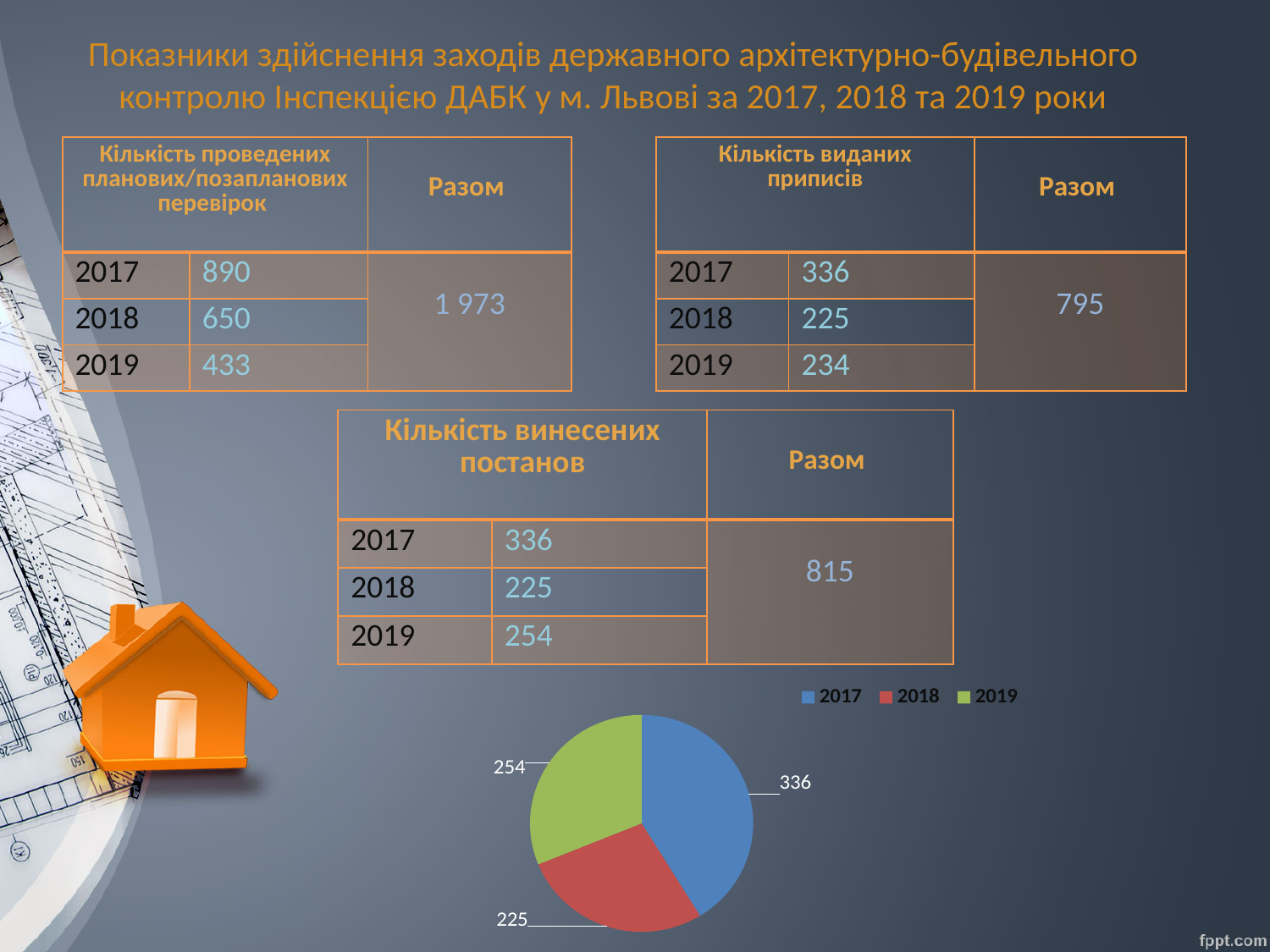
What kind of chart is shown at the bottom of the slide? pie chart In the pie chart, what is the value for 2019? 254 In the pie chart, what is the value for 2018? 225 How many entries does the pie chart's legend list? 3 In the pie chart, what is the difference between the values for 2017 and 2018? 111 In the pie chart, which is larger: the value for 2019 or the value for 2018? 2019 In the pie chart, what is the difference between the values for 2019 and 2018? 29 In the pie chart, what is the value for 2017? 336 In the pie chart, what colour is the slice for 2019? green In the pie chart, which year has the smallest slice? 2018 In the pie chart, which year has the largest slice? 2017 How many slices does the pie chart have? 3